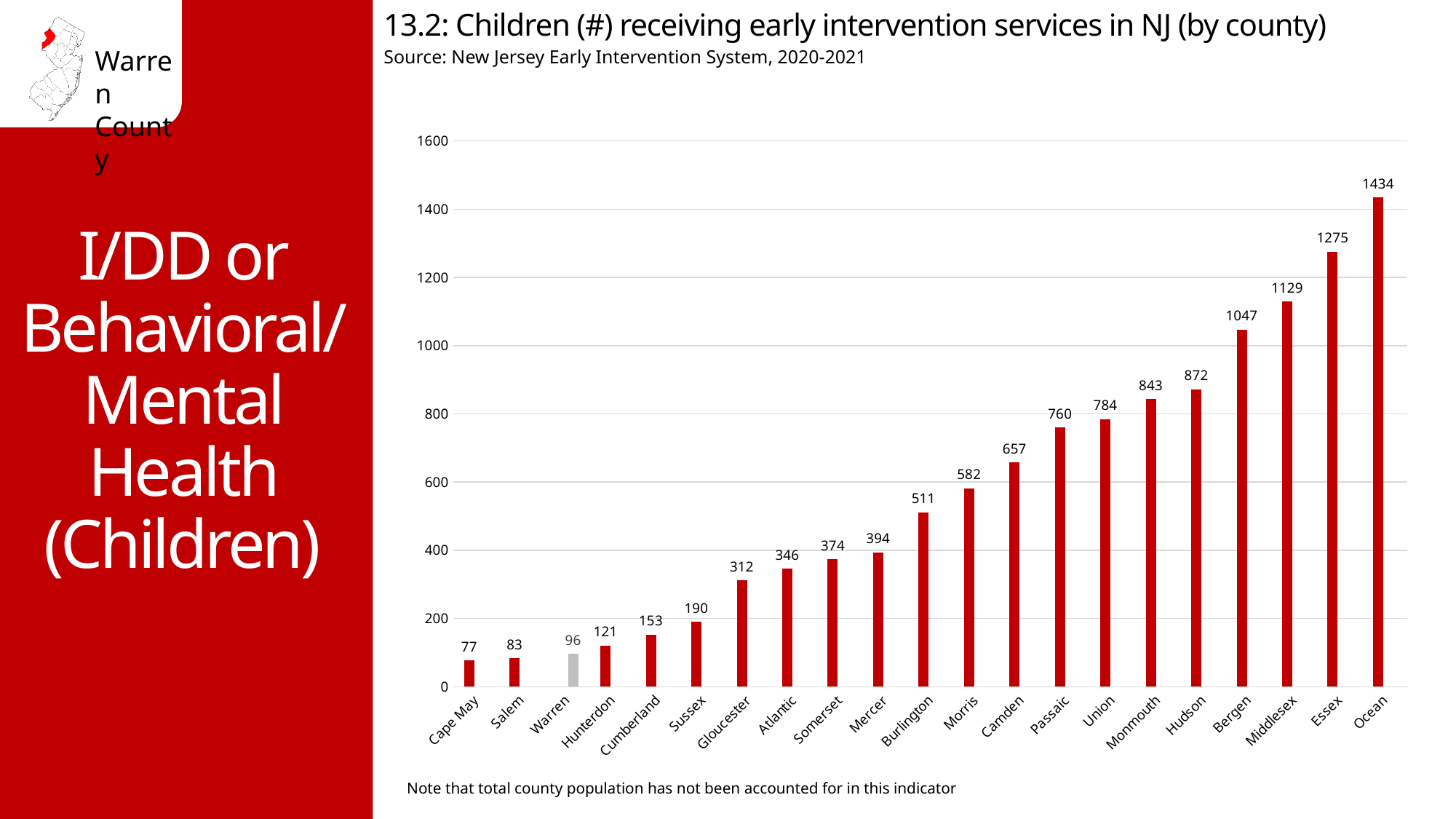
What is the difference between the values for Warren and Cape May? 19 What is the difference between the values for Essex and Middlesex? 146 Is the value for Bergen greater or less than 1000? greater Which county has the lowest number of children receiving early intervention services? Cape May Which county has a larger value, Camden or Burlington? Camden How many children received early intervention services in Warren County? 96 How many counties are shown on the chart? 21 Do the values rise or fall moving from left to right along the x axis? Rise What is the value shown for Ocean County? 1434 What is the value shown for Mercer County? 394 What type of chart is used on this slide? Bar chart Which county has the highest number of children receiving early intervention services? Ocean